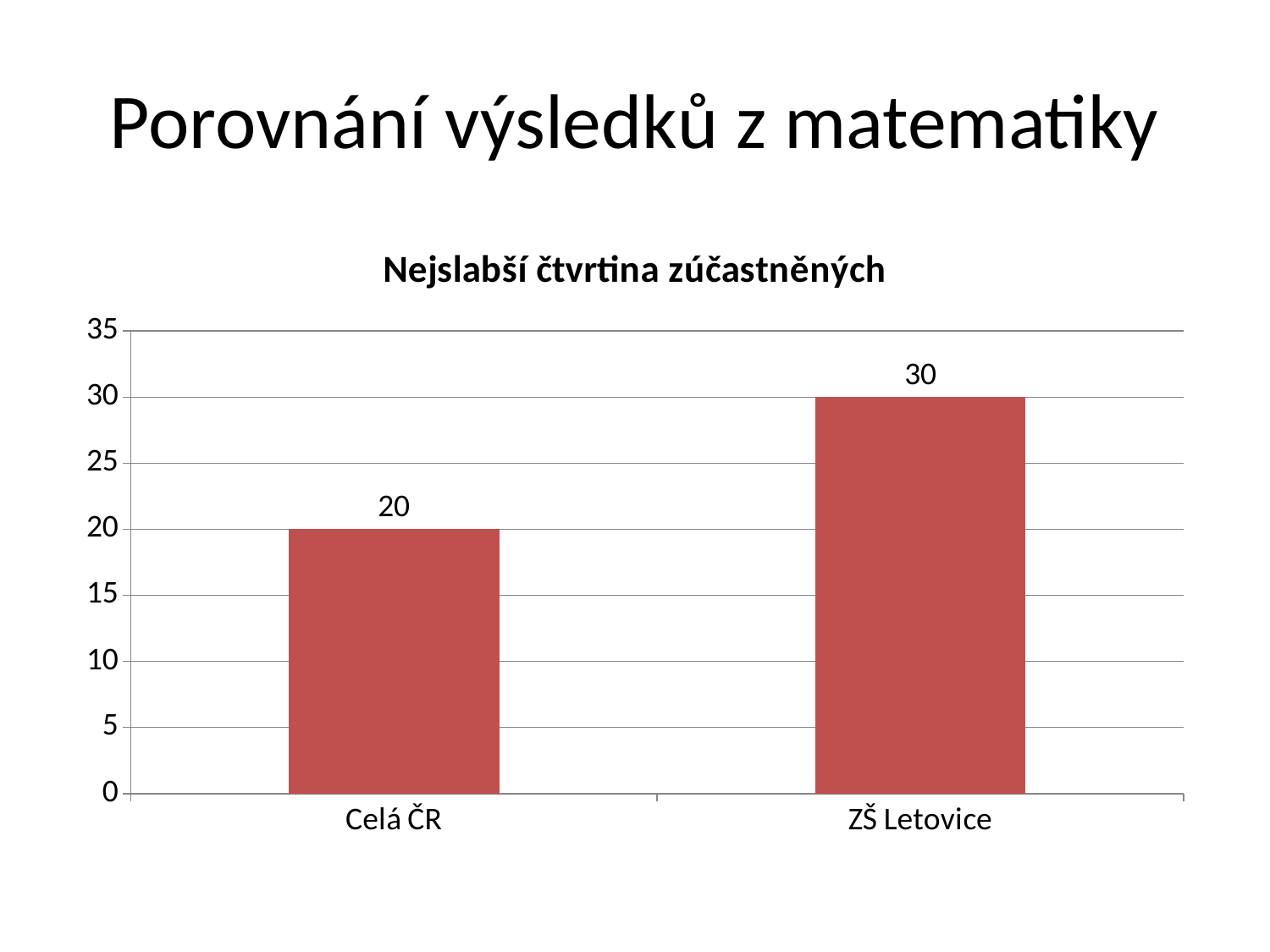
What is the value for Celá ČR? 20 What is the difference between the values for ZŠ Letovice and Celá ČR? 10 What is the highest value shown on the vertical axis? 35 How many categories are shown in the chart? 2 Is the value for Celá ČR greater or less than 25? less Which category has the lowest value? Celá ČR Which is larger, the value for Celá ČR or the value for ZŠ Letovice? ZŠ Letovice What is the title of the chart? Nejslabší čtvrtina zúčastněných Is the value for ZŠ Letovice greater or less than 25? greater Which category has the highest value? ZŠ Letovice What is the value for ZŠ Letovice? 30 What kind of chart is shown on the slide? bar chart